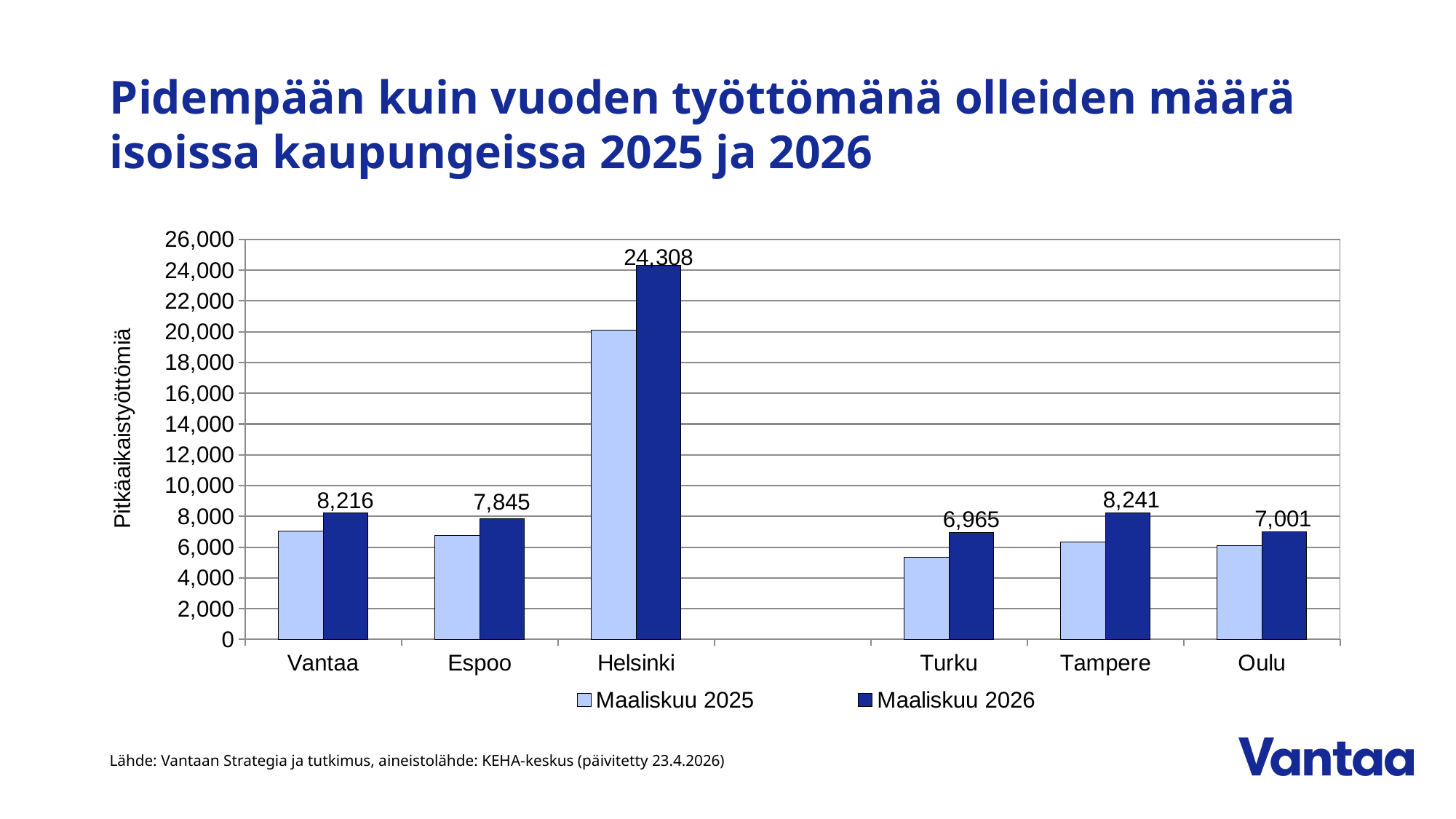
What is the value for Turku in the Maaliskuu 2026 series? 6,965 Which city has the highest value in the Maaliskuu 2026 series? Helsinki Is the Maaliskuu 2025 value for Helsinki greater or less than 18,000? greater What kind of chart is shown on the slide? bar chart How many cities are shown on the x axis? 6 What is the difference between the Maaliskuu 2026 values for Tampere and Vantaa? 25 In the Maaliskuu 2026 series, which is larger: Espoo or Oulu? Espoo How many series does the legend list? 2 Is the Maaliskuu 2025 value for Turku greater or less than 6,000? less Which city has the lowest value in the Maaliskuu 2026 series? Turku What is the difference between the Maaliskuu 2026 values for Helsinki and Espoo? 16,463 What is the value for Helsinki in the Maaliskuu 2026 series? 24,308